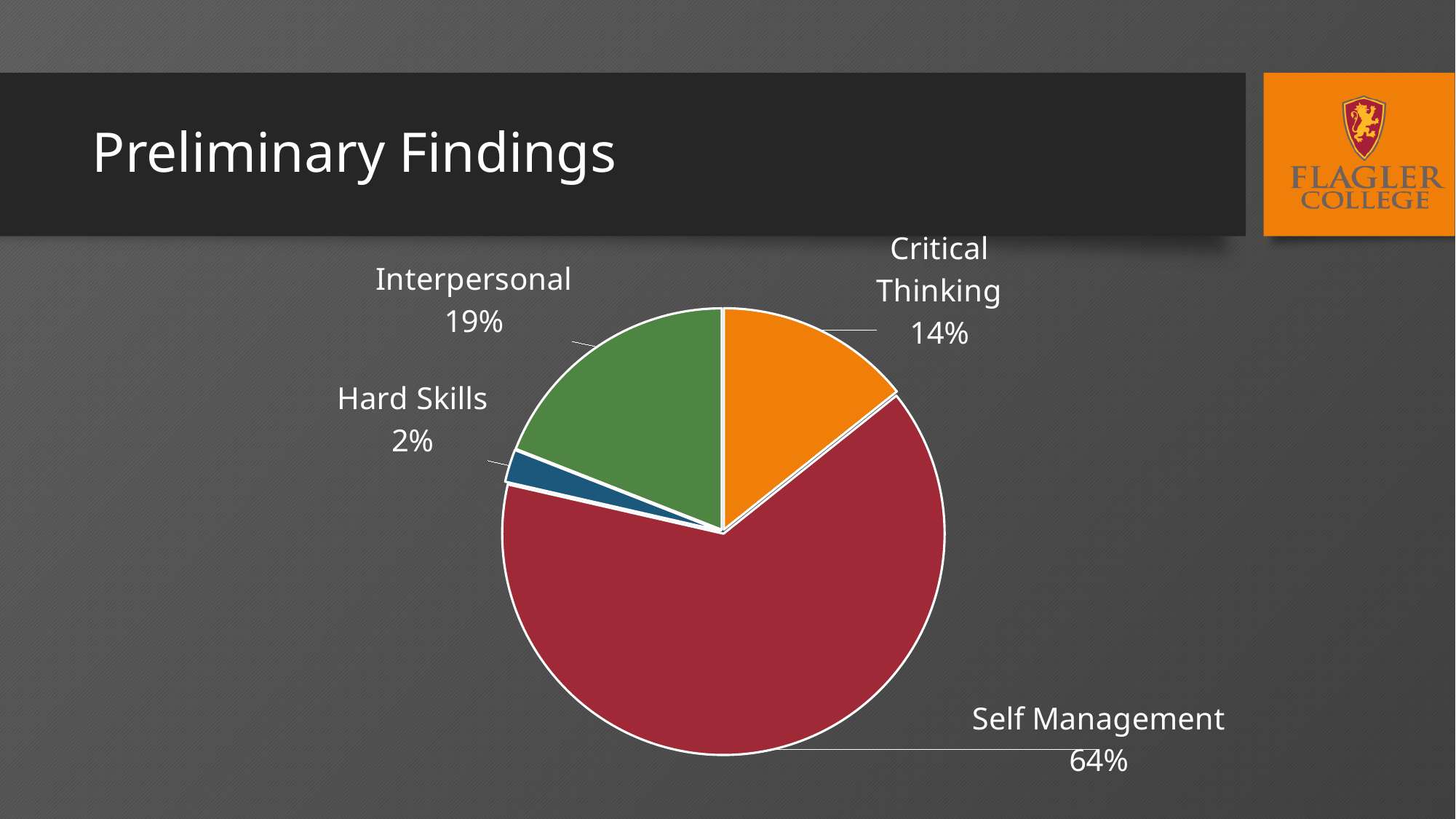
What is the difference in percentage points between Interpersonal and Critical Thinking? 5 What share of the pie does Self Management represent? 64% What share of the pie does Hard Skills represent? 2% What kind of chart is shown on the slide? pie chart What colour is the Self Management slice? red Which category has the smallest slice of the pie? Hard Skills Which category has the largest slice of the pie? Self Management Which is larger, the Interpersonal slice or the Critical Thinking slice? Interpersonal How many slices does the pie chart have? 4 What share of the pie does Interpersonal represent? 19% What is the difference in percentage points between Self Management and Interpersonal? 45